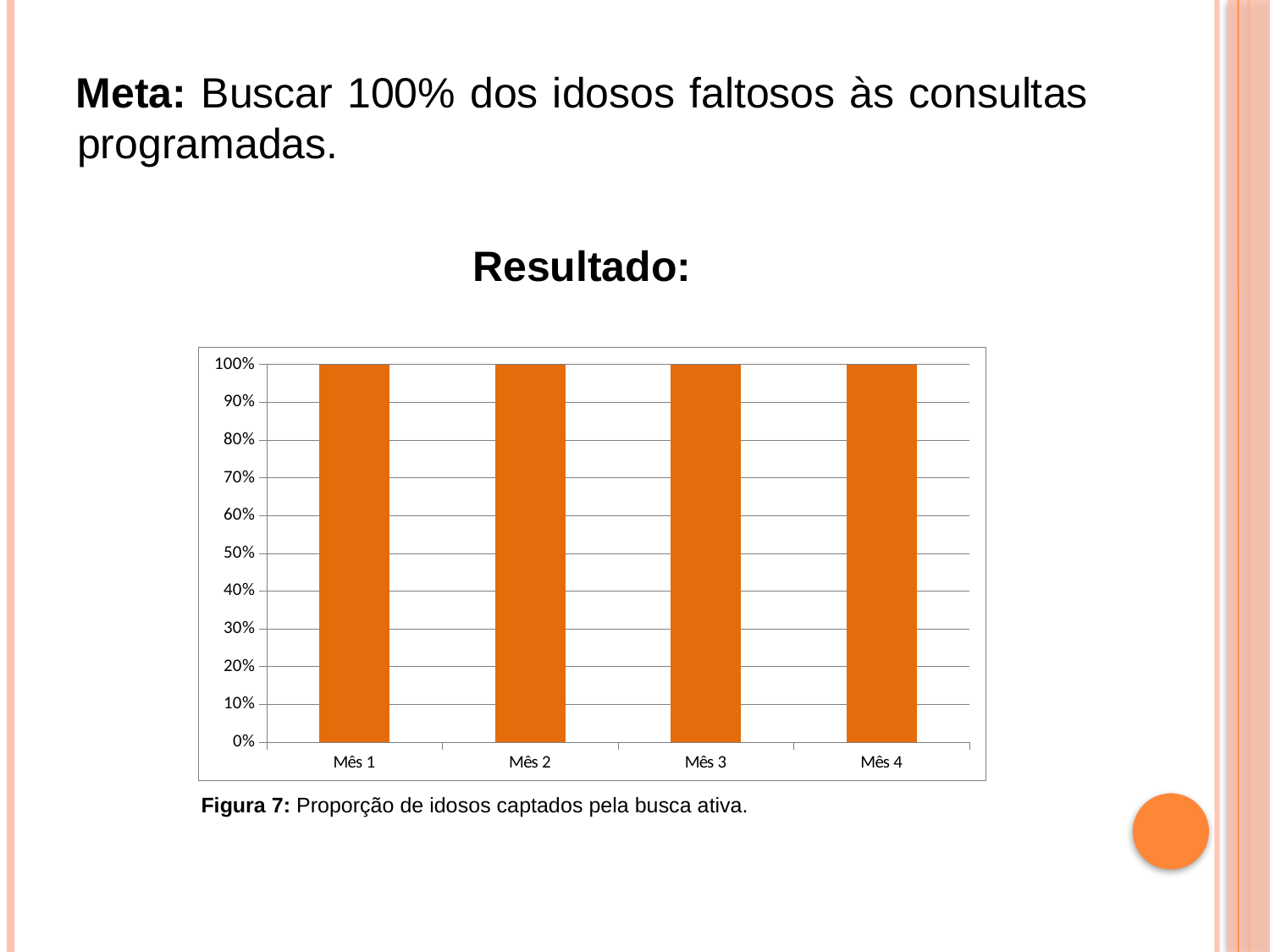
How many categories (months) are shown on the x axis of the chart? 4 Is the value for Mês 3 greater or less than 50%? greater What is the highest value shown on the y axis of the chart? 100% What is the value for Mês 4 in the chart? 100% What is the value for Mês 3 in the chart? 100% What is the value for Mês 2 in the chart? 100% What kind of chart is shown on the slide? bar chart What is the value for Mês 1 in the chart? 100% What is the difference between the values for Mês 1 and Mês 4? 0% Do the values rise, fall or stay the same from Mês 1 to Mês 4? stay the same What is the caption of the figure below the chart? Figura 7: Proporção de idosos captados pela busca ativa.